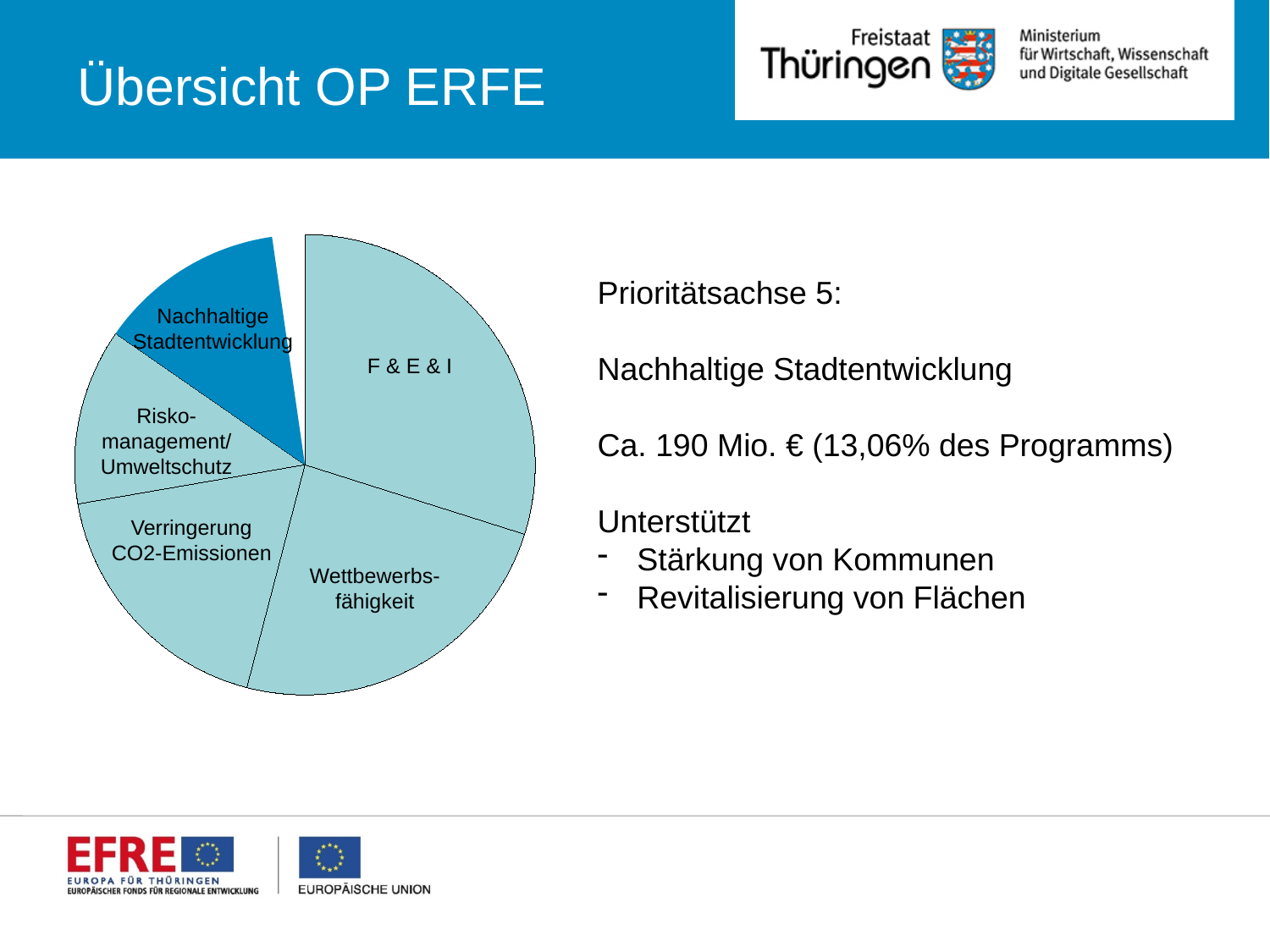
Which slice lies between Verringerung CO2-Emissionen and Nachhaltige Stadtentwicklung in the pie chart? Risikomanagement/Umweltschutz Which slice is larger, F & E & I or Risikomanagement/Umweltschutz? F & E & I How many slices does the pie chart have? 6 Which slice is larger, F & E & I or Wettbewerbsfähigkeit? F & E & I Which slice of the pie chart is shown in a darker blue than the others? Nachhaltige Stadtentwicklung Which slice is larger, Wettbewerbsfähigkeit or Verringerung CO2-Emissionen? Wettbewerbsfähigkeit Which slice of the pie chart is the largest? F & E & I According to the text on the slide, what share of the programme does the Nachhaltige Stadtentwicklung slice represent? 13,06% What kind of chart is shown on the slide? pie chart